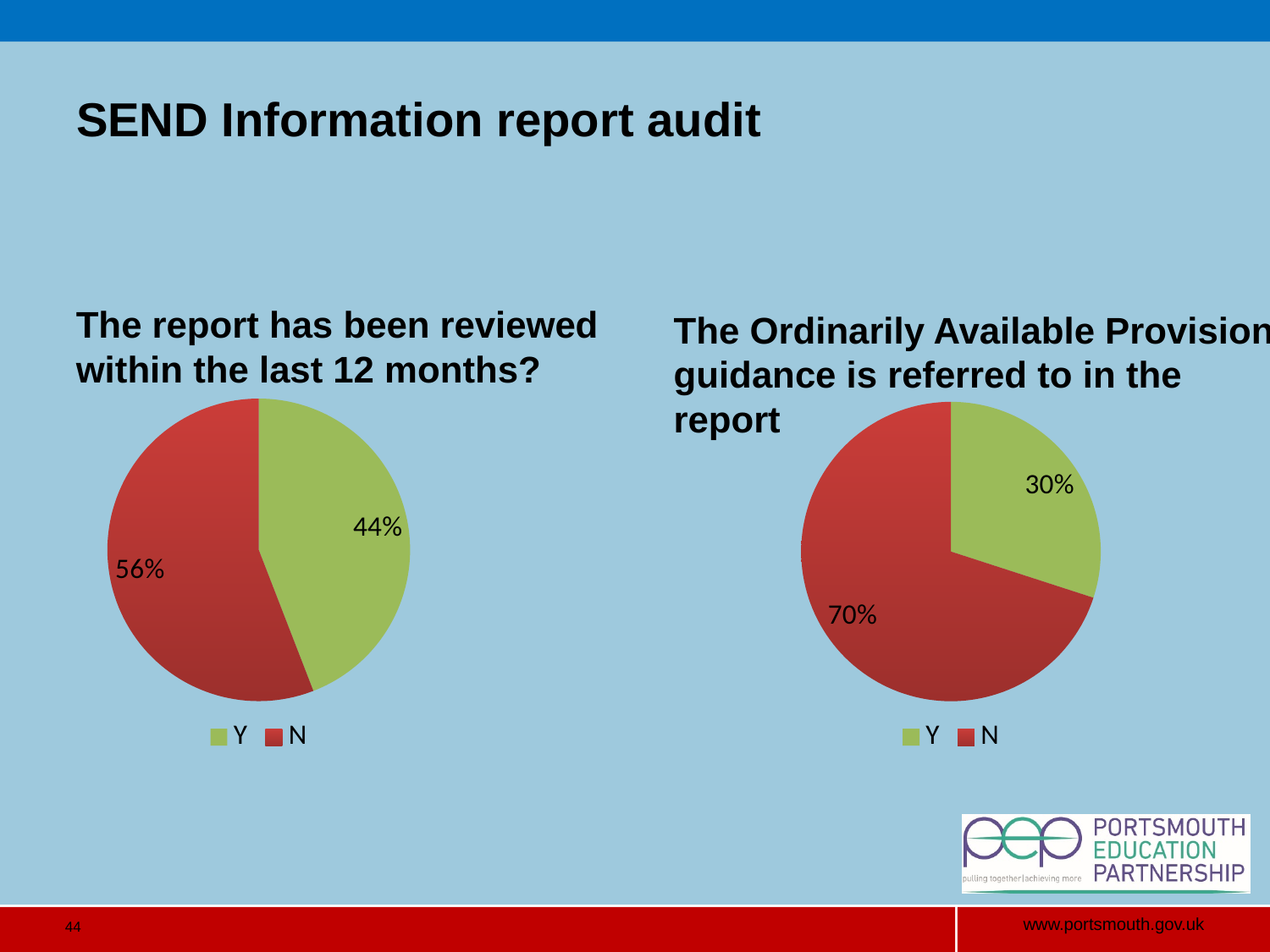
In the left pie chart, what colour is the N slice? Red In the left pie chart ('The report has been reviewed within the last 12 months?'), what share is labelled for Y? 44% In the left pie chart ('The report has been reviewed within the last 12 months?'), what share is labelled for N? 56% In the left pie chart, which slice is larger, Y or N? N In the right pie chart ('The Ordinarily Available Provision guidance is referred to in the report'), what share is labelled for N? 70% In the right pie chart, which slice is the largest? N How many entries does the legend of the right pie chart list? 2 In the right pie chart, which slice is the smallest? Y In the right pie chart ('The Ordinarily Available Provision guidance is referred to in the report'), what share is labelled for Y? 30% In the right pie chart, what is the difference in percentage points between the N and Y slices? 40 What type of chart is used on the left of the slide? Pie chart In the left pie chart, what is the difference in percentage points between the N and Y slices? 12